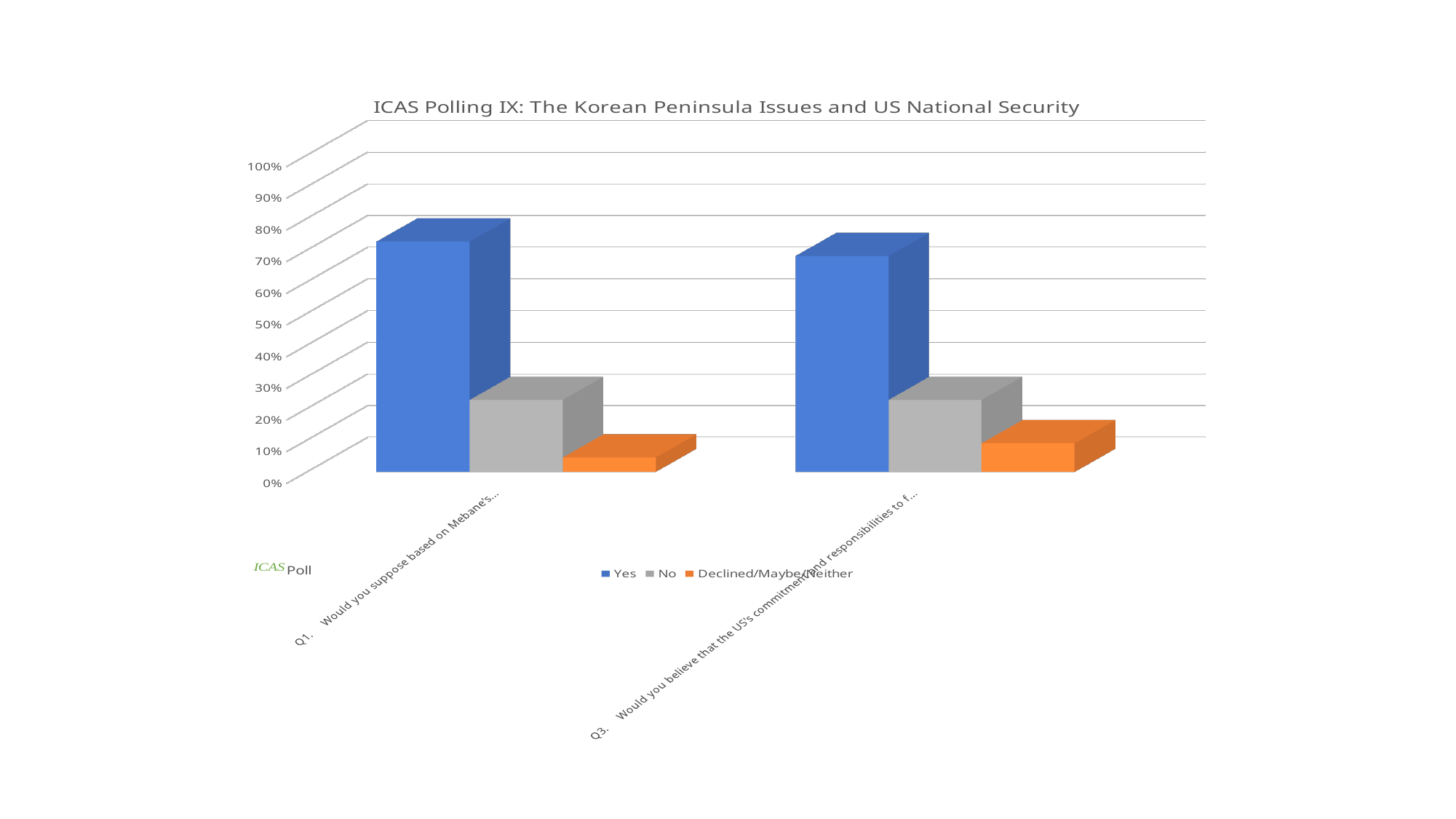
Is the Yes value for Q3 greater or less than 80%? less How many series does the legend list? 3 Which is larger, the Yes value for Q1 or the Yes value for Q3? Q1 What kind of chart is shown on the slide? bar chart Which response has the lowest value for Q3? Declined/Maybe/Neither Which response has the highest value for Q1? Yes Which series is shown in orange in the legend? Declined/Maybe/Neither What is the title of the chart? ICAS Polling IX: The Korean Peninsula Issues and US National Security Is the Yes value for Q1 greater or less than 60%? greater How many question categories are plotted on the x axis? 2 Is the Declined/Maybe/Neither value for Q3 greater or less than 20%? less